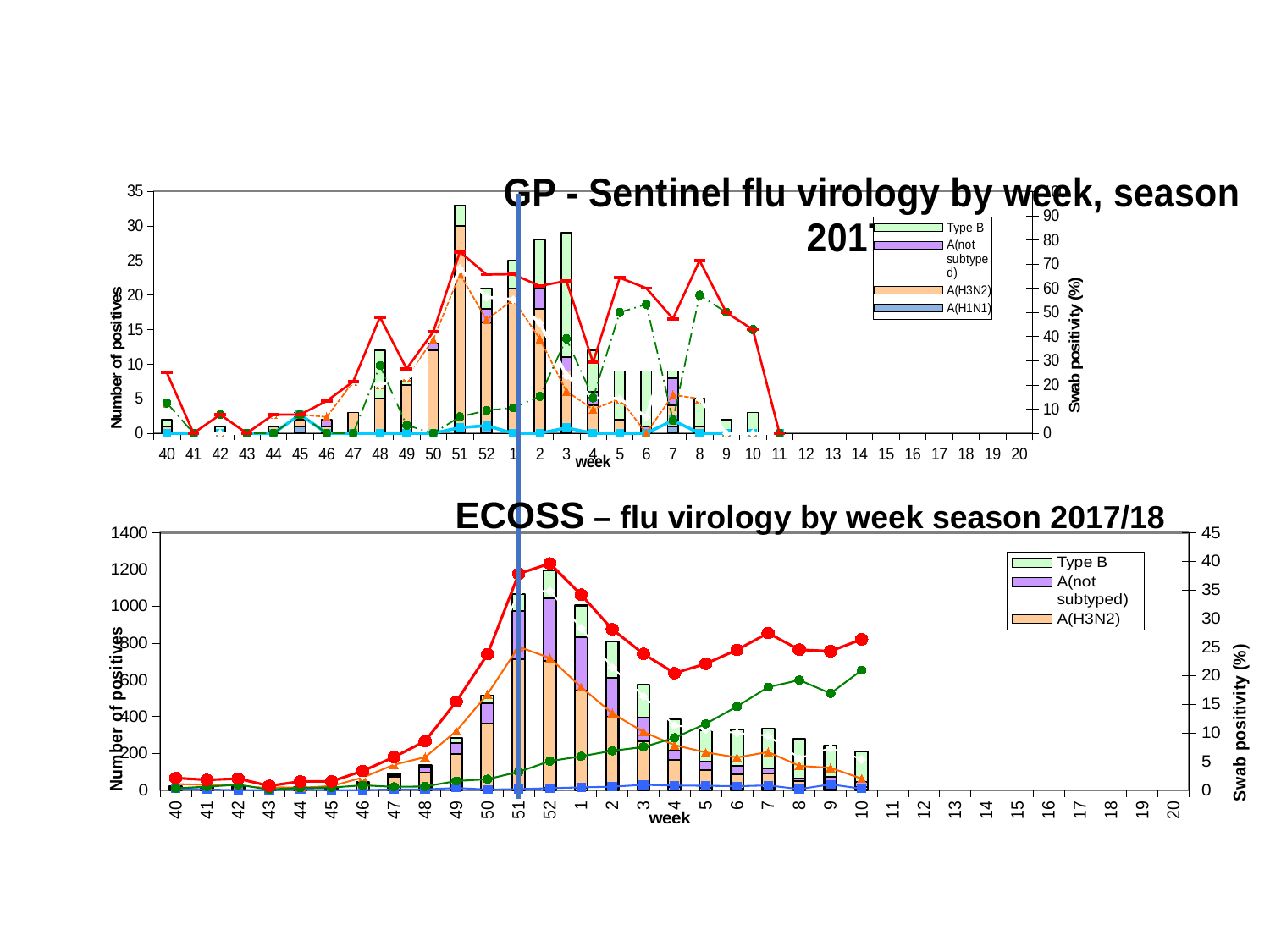
On the GP - Sentinel chart, do the stacked bars rise or fall from week 45 to week 51? rise On the ECOSS chart, do the stacked bars rise or fall from week 52 to week 10? fall On the ECOSS chart, which stacked bar is taller, week 52 or week 4? week 52 On the ECOSS chart, is the total number of positives for week 48 greater or less than 200? less On the GP - Sentinel chart, is the total number of positives for week 48 greater or less than 10? greater What kind of chart is the ECOSS – flu virology by week season 2017/18 chart? bar chart (stacked, with line series) On the GP - Sentinel chart, which week has the tallest stacked bar? 51 On the ECOSS chart, is the total number of positives for week 52 greater or less than 1000? greater On the GP - Sentinel chart, how many series does the legend list? 4 On the ECOSS chart, how many series does the legend list? 3 On the ECOSS chart, what is the title of the right-hand vertical axis? Swab positivity (%)